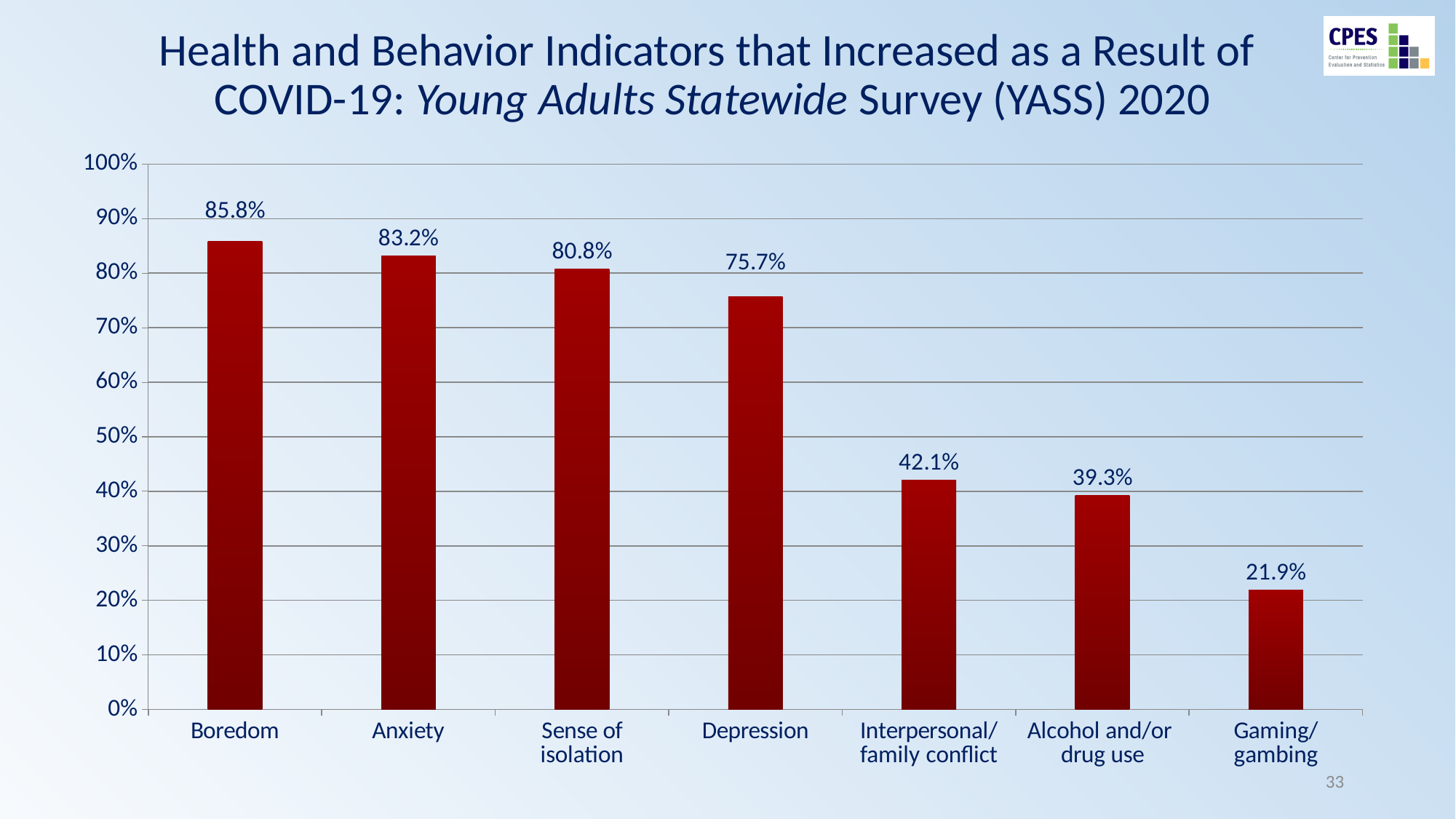
How many categories are shown on the x axis? 7 Which category has the lowest value? Gaming/gambling What is the difference between the values for Interpersonal/family conflict and Gaming/gambling? 20.2% What is the value for Depression? 75.7% What is the difference between the values for Boredom and Anxiety? 2.6% What kind of chart is shown on the slide? bar chart Is the value for Interpersonal/family conflict greater or less than 50%? less What is the value for Boredom? 85.8% What is the value for Alcohol and/or drug use? 39.3% Which is larger, the value for Sense of isolation or the value for Depression? Sense of isolation Do the values rise or fall from left to right along the x axis? fall Which category has the highest value? Boredom